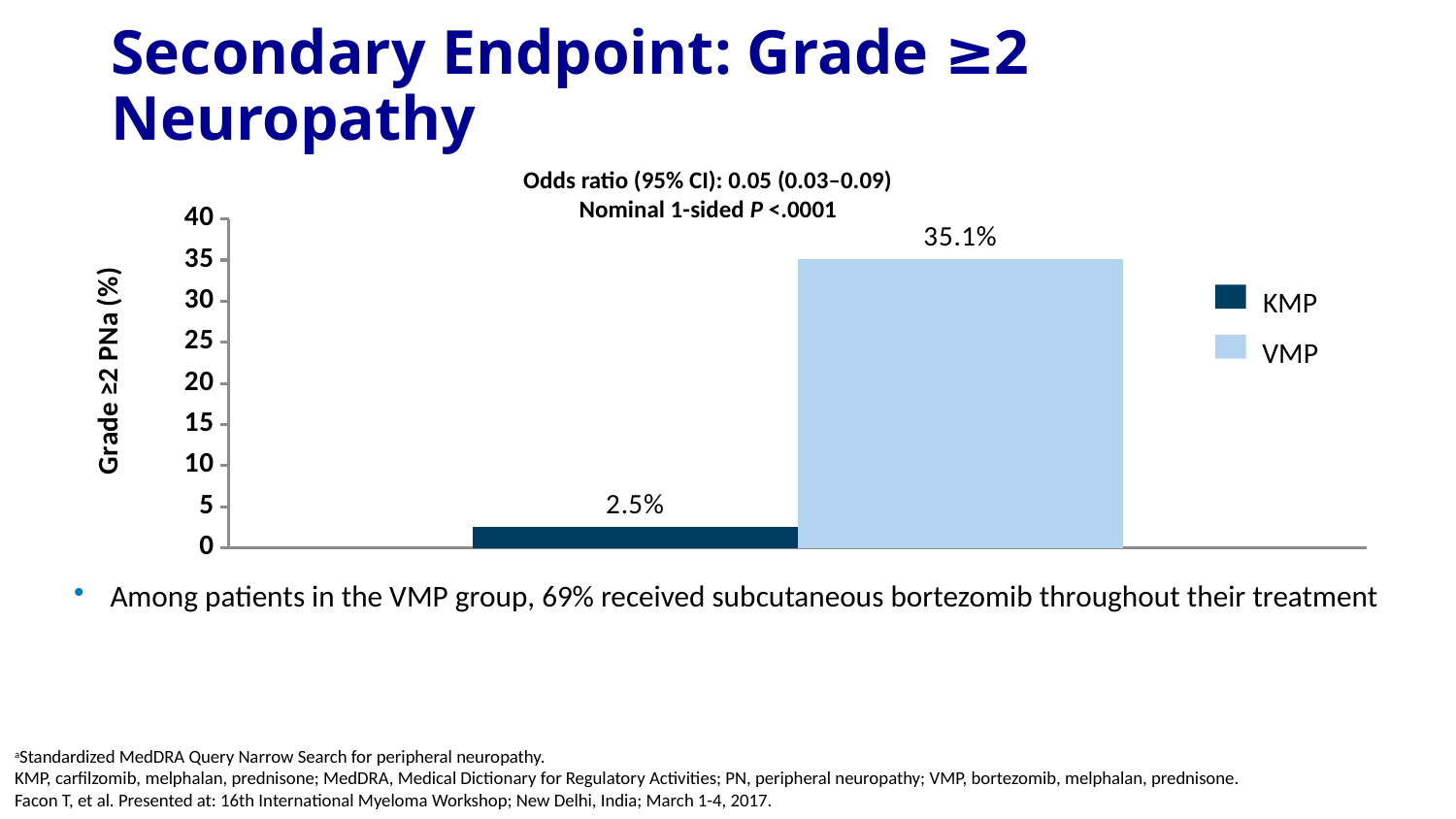
What is the Grade ≥2 PN rate for the KMP group? 2.5% What is the label of the y axis? Grade ≥2 PNa (%) What is the Grade ≥2 PN rate for the VMP group? 35.1% What kind of chart is shown on the slide? Bar chart Which group has the higher Grade ≥2 PN rate? VMP How many series does the legend list? 2 Is the Grade ≥2 PN rate for VMP greater or less than 30? greater Is the Grade ≥2 PN rate for KMP greater or less than 5? less What is the maximum value shown on the y axis? 40 What odds ratio is shown above the chart? 0.05 (0.03–0.09) What is the difference in Grade ≥2 PN rate between VMP and KMP? 32.6% Which group has the lower Grade ≥2 PN rate? KMP